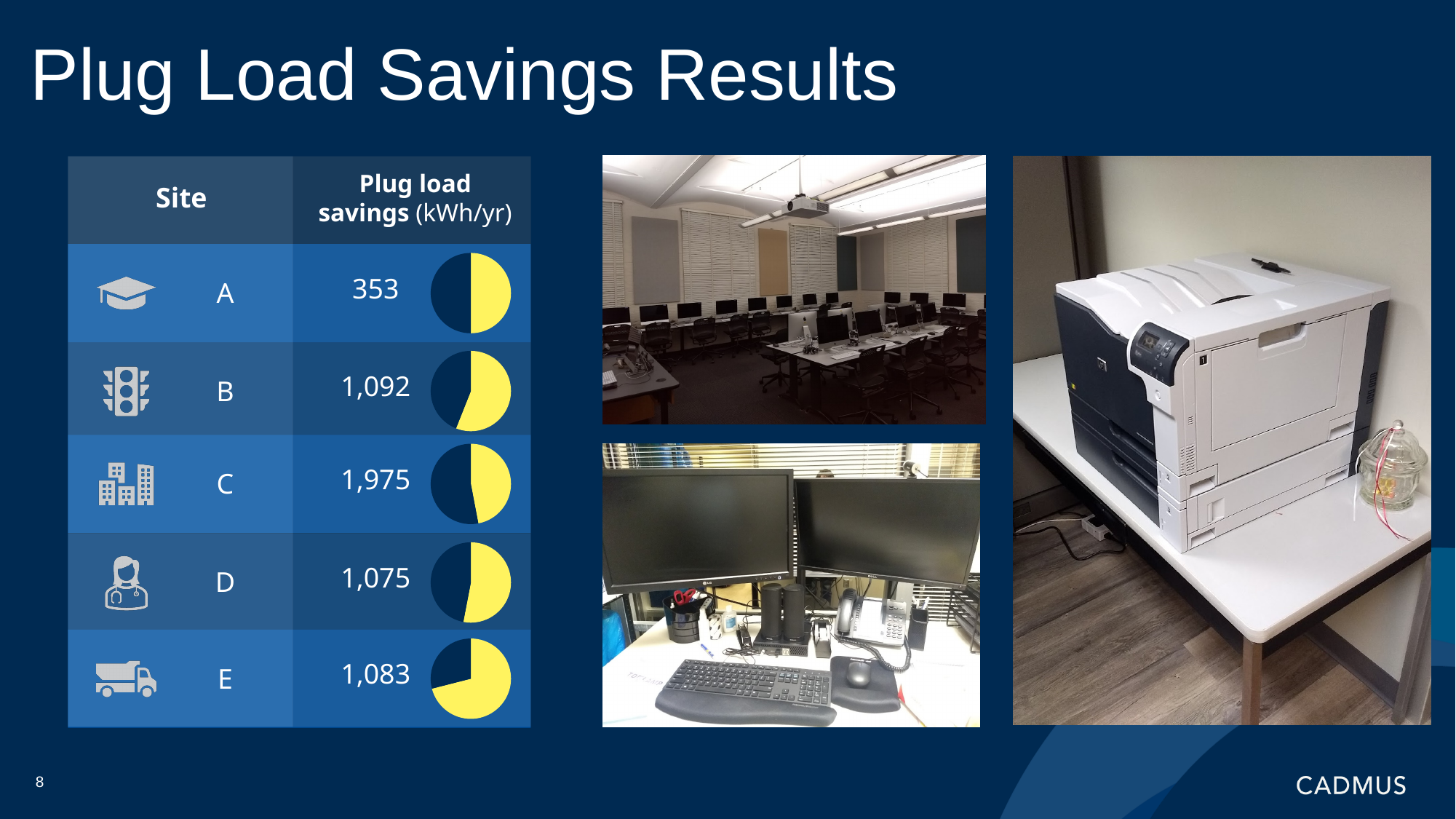
What colour is used for the filled portion of each site's pie chart? yellow How many sites are listed in the plug load savings table? 5 Which site has the lowest plug load savings? A What unit is used for the plug load savings values? kWh/yr Which site has the highest plug load savings? C What is the difference in plug load savings between Site C and Site A? 1,622 Which has larger plug load savings, Site B or Site E? B What is the plug load savings value for Site C? 1,975 What is the difference in plug load savings between Site B and Site D? 17 What is the plug load savings value for Site A? 353 What kind of chart is shown next to each site's savings value? pie chart What is the plug load savings value for Site E? 1,083